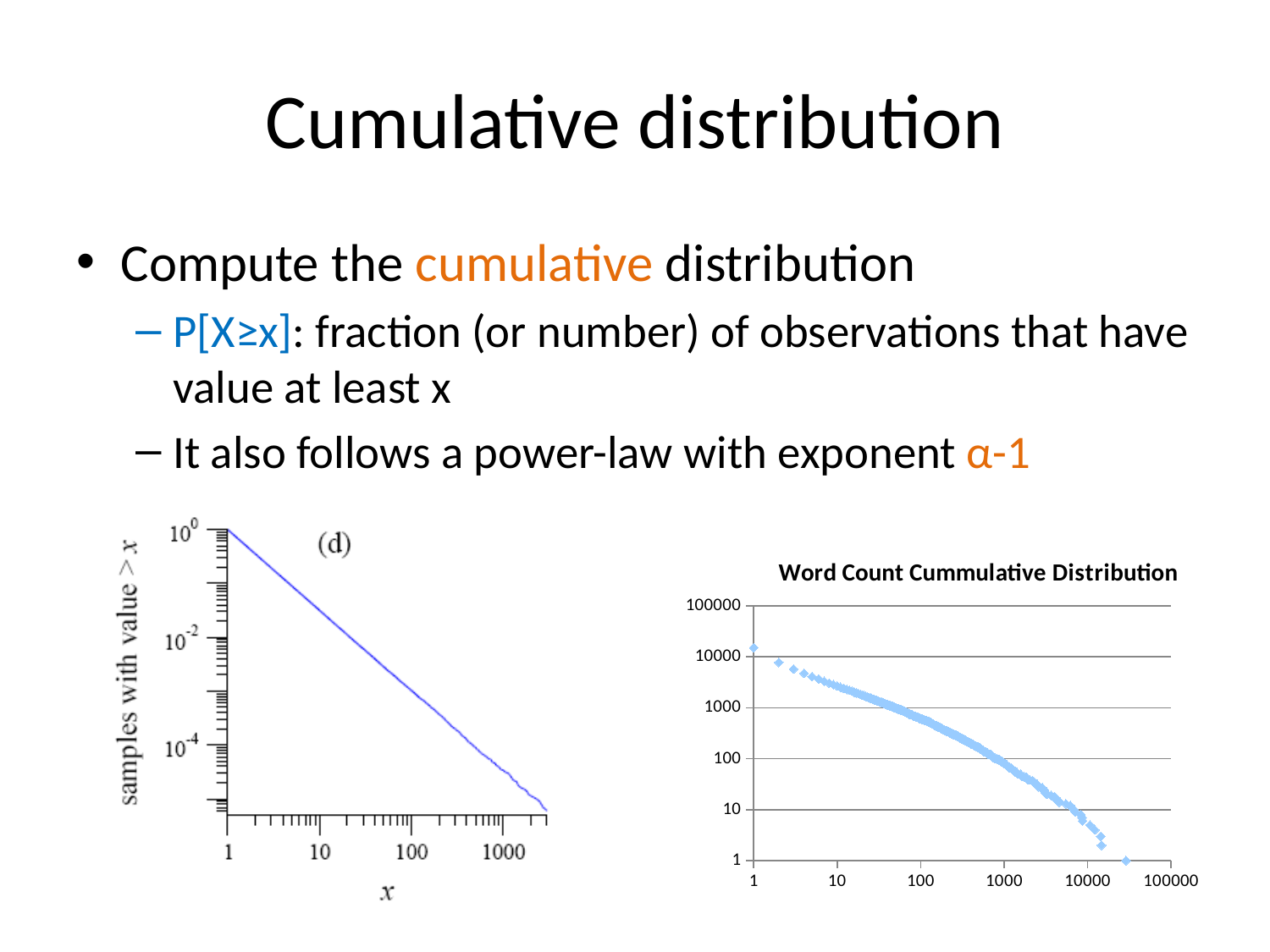
In the chart on the left of the slide, what is the label on the y axis? samples with value > x In the chart on the left of the slide, what kind of chart is shown? line chart In the Word Count Cummulative Distribution chart, is the value at x = 1 greater or less than 10000? greater In the Word Count Cummulative Distribution chart, what is the largest tick value shown on the y axis? 100000 In the Word Count Cummulative Distribution chart, which has the larger value: the point at x = 1 or the point at x = 100? the point at x = 1 What is the title of the chart on the right of the slide? Word Count Cummulative Distribution In the Word Count Cummulative Distribution chart, is the value at x = 100 greater or less than 1000? less In the Word Count Cummulative Distribution chart, is the value at x = 10 greater or less than 1000? greater In the Word Count Cummulative Distribution chart, do the values rise or fall as x increases? fall In the chart on the left of the slide, does the plotted line rise or fall as x increases? fall In the Word Count Cummulative Distribution chart, what kind of chart is used to plot the data? scatter chart